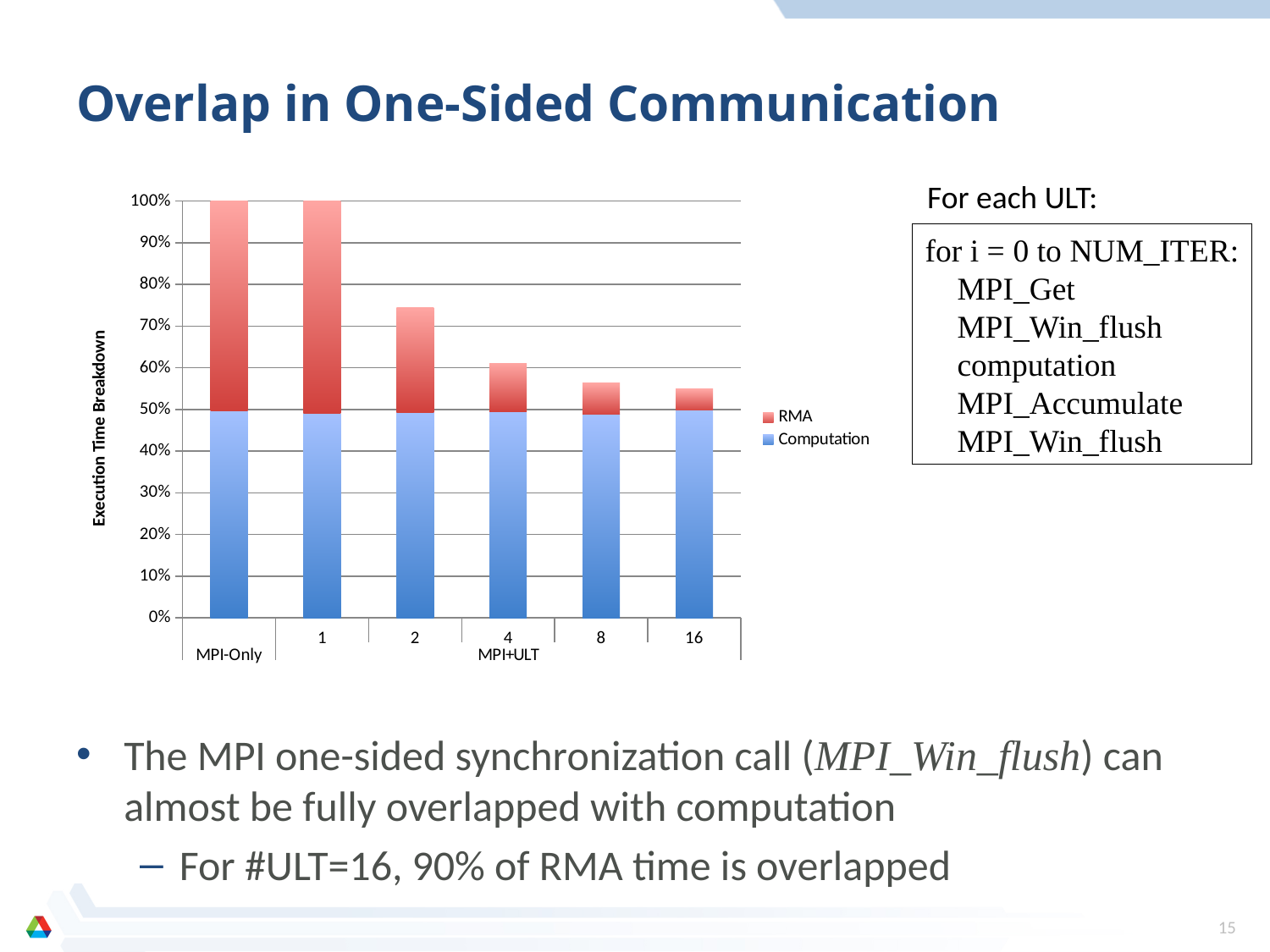
Is the total height of the bar for MPI+ULT with 8 ULTs greater or less than 50%? greater Is the total height of the bar for MPI+ULT with 2 ULTs greater or less than 70%? greater Which series is shown in red in the chart? RMA What kind of chart is shown on the slide? Stacked bar chart Which bar has the larger total height: MPI+ULT with 2 ULTs or MPI+ULT with 4 ULTs? 2 ULTs As the number of ULTs increases from 1 to 16, do the total bar heights rise or fall? fall Is the total height of the bar for MPI+ULT with 16 ULTs greater or less than 60%? less How many series does the chart legend list? 2 How many bars are plotted in the chart? 6 What is the title of the chart's vertical axis? Execution Time Breakdown